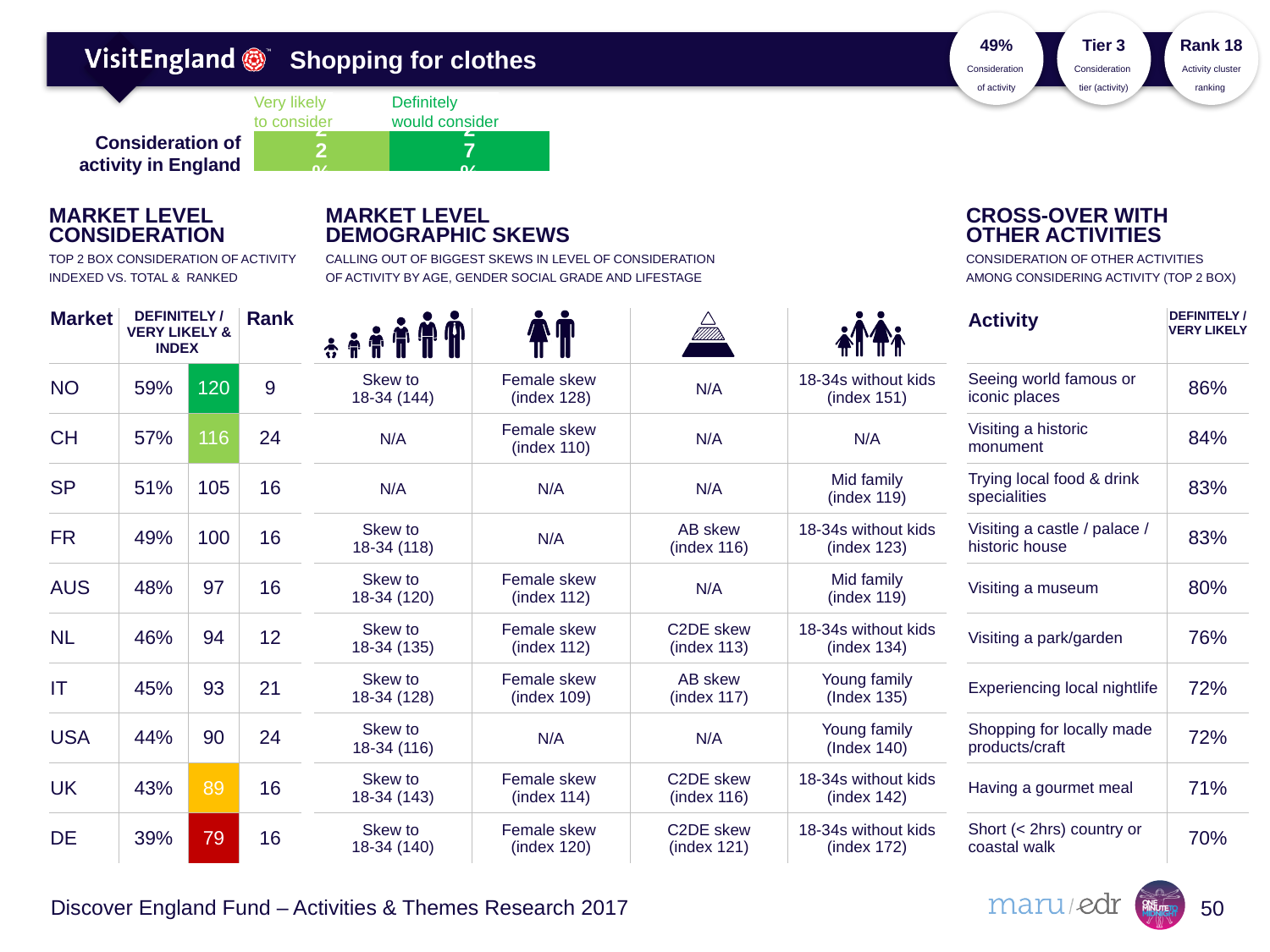
In the 'Consideration of activity in England' chart, which is larger: 'Very likely to consider' or 'Definitely would consider'? Definitely would consider In the 'Consideration of activity in England' chart, which segment is shown in the darker green? Definitely would consider In the 'Consideration of activity in England' chart, what is the difference between 'Definitely would consider' and 'Very likely to consider'? 5% What kind of chart is the 'Consideration of activity in England' chart? bar chart In the 'Consideration of activity in England' chart, what is the value for 'Very likely to consider'? 22% In the 'Consideration of activity in England' chart, which segment is shown in the lighter green? Very likely to consider What is the total of the stacked bar in the 'Consideration of activity in England' chart? 49% In the 'Consideration of activity in England' chart, what is the value for 'Definitely would consider'? 27% How many series does the 'Consideration of activity in England' chart show? 2